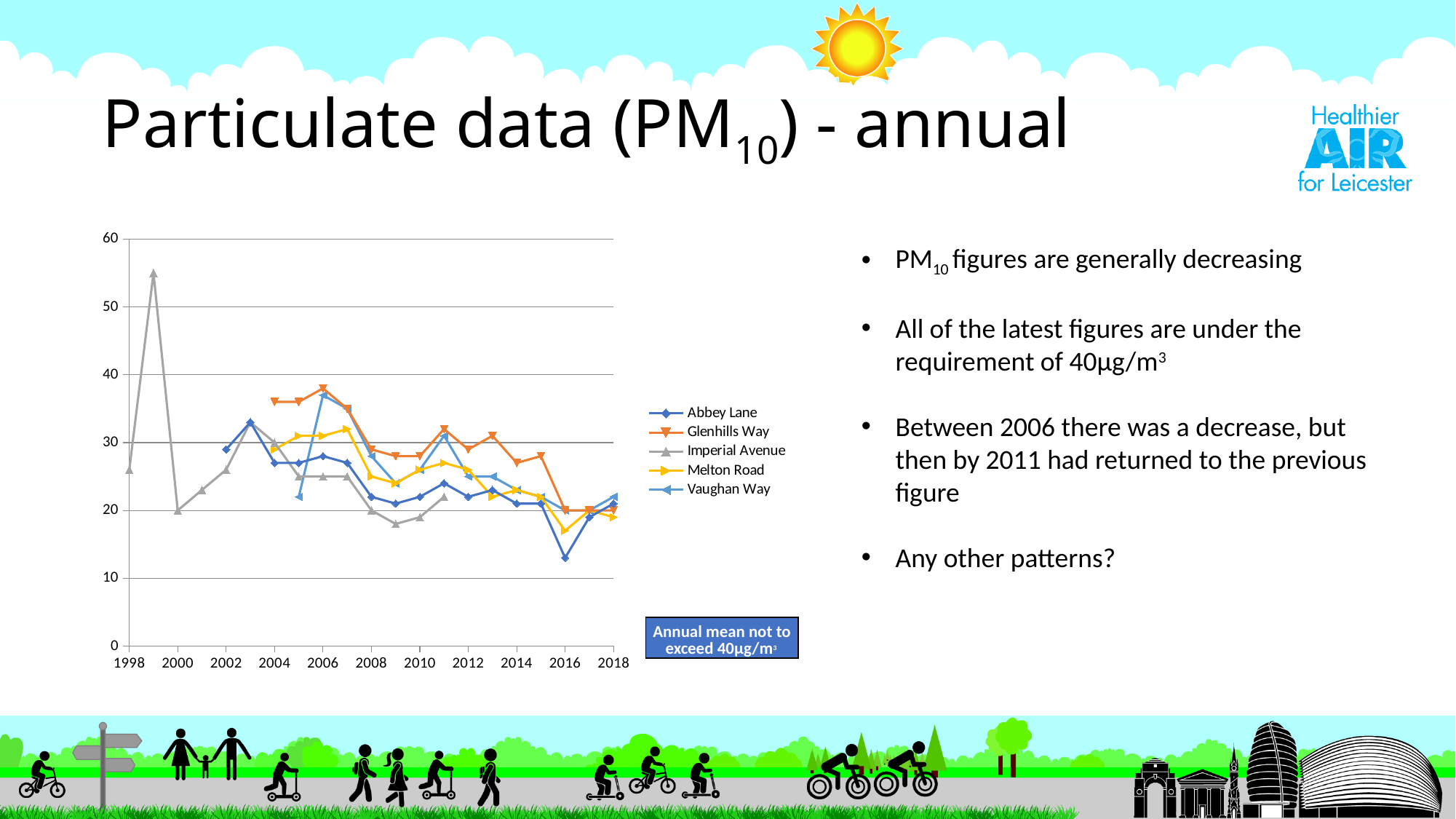
What kind of chart is shown on the slide? line chart Do the values for Glenhills Way generally rise or fall between 2006 and 2018? fall What limit does the text box next to the chart say the annual mean must not exceed? 40µg/m³ Which series reaches the highest value anywhere on the chart? Imperial Avenue Which series has data plotted for 1998, the earliest year on the x axis? Imperial Avenue Is the value for Imperial Avenue in 2009 greater or less than 20? less Is the value for Glenhills Way in 2006 greater or less than 30? greater How many series does the chart's legend list? 5 Is the value for Imperial Avenue in 1999 greater or less than 50? greater In 2006, which series has the larger value: Glenhills Way or Imperial Avenue? Glenhills Way